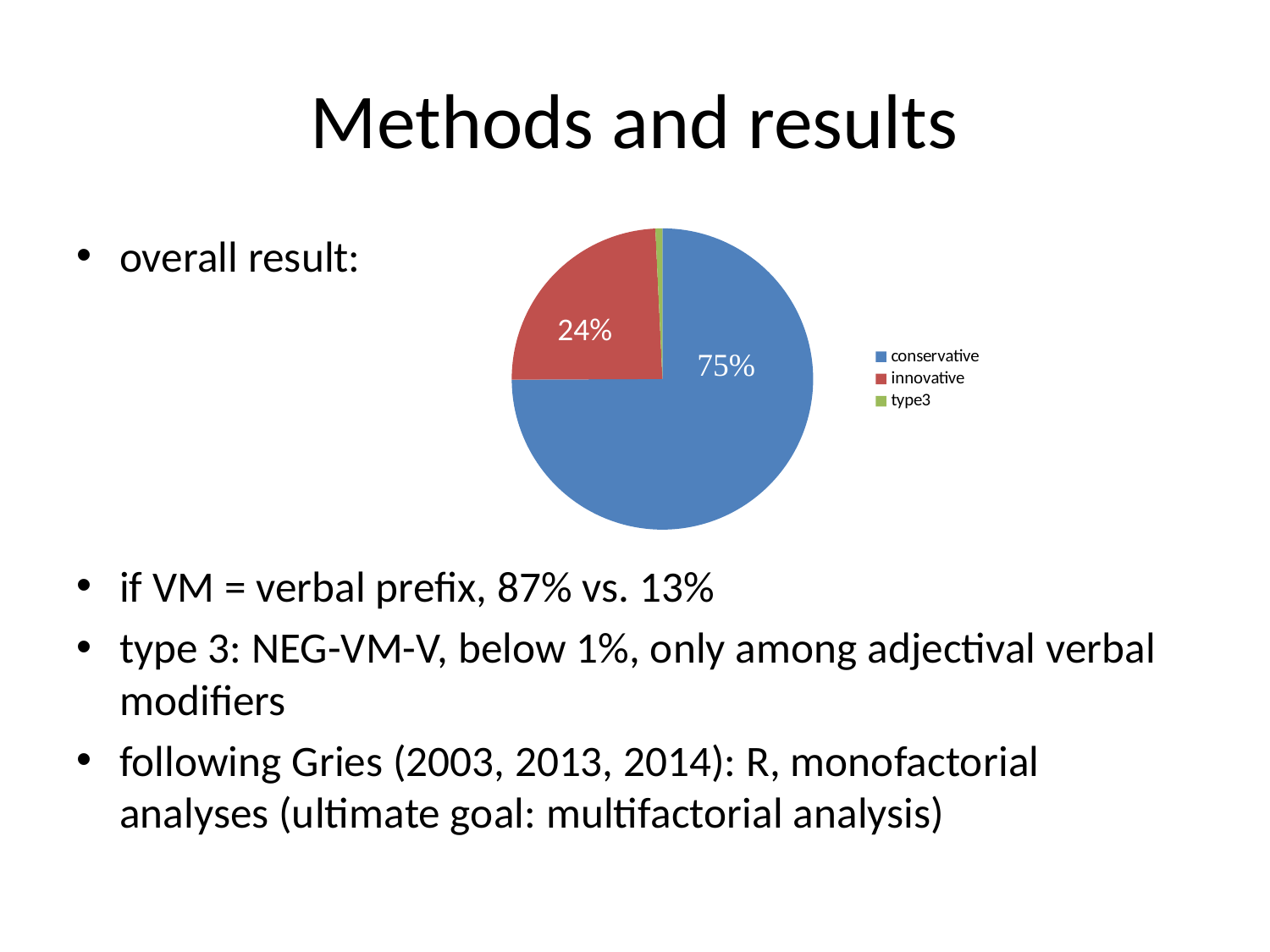
What share of the pie does the conservative slice have? 75% Which category has the largest slice of the pie? conservative What colour is the conservative slice? blue What is the difference in percentage points between the conservative and innovative slices? 51 What kind of chart is shown on the slide? pie chart What colour is the innovative slice? red Which slice is larger, conservative or innovative? conservative How many categories does the legend list? 3 What share of the pie does the innovative slice have? 24% Which slice is larger, innovative or type3? innovative Which category has the smallest slice of the pie? type3